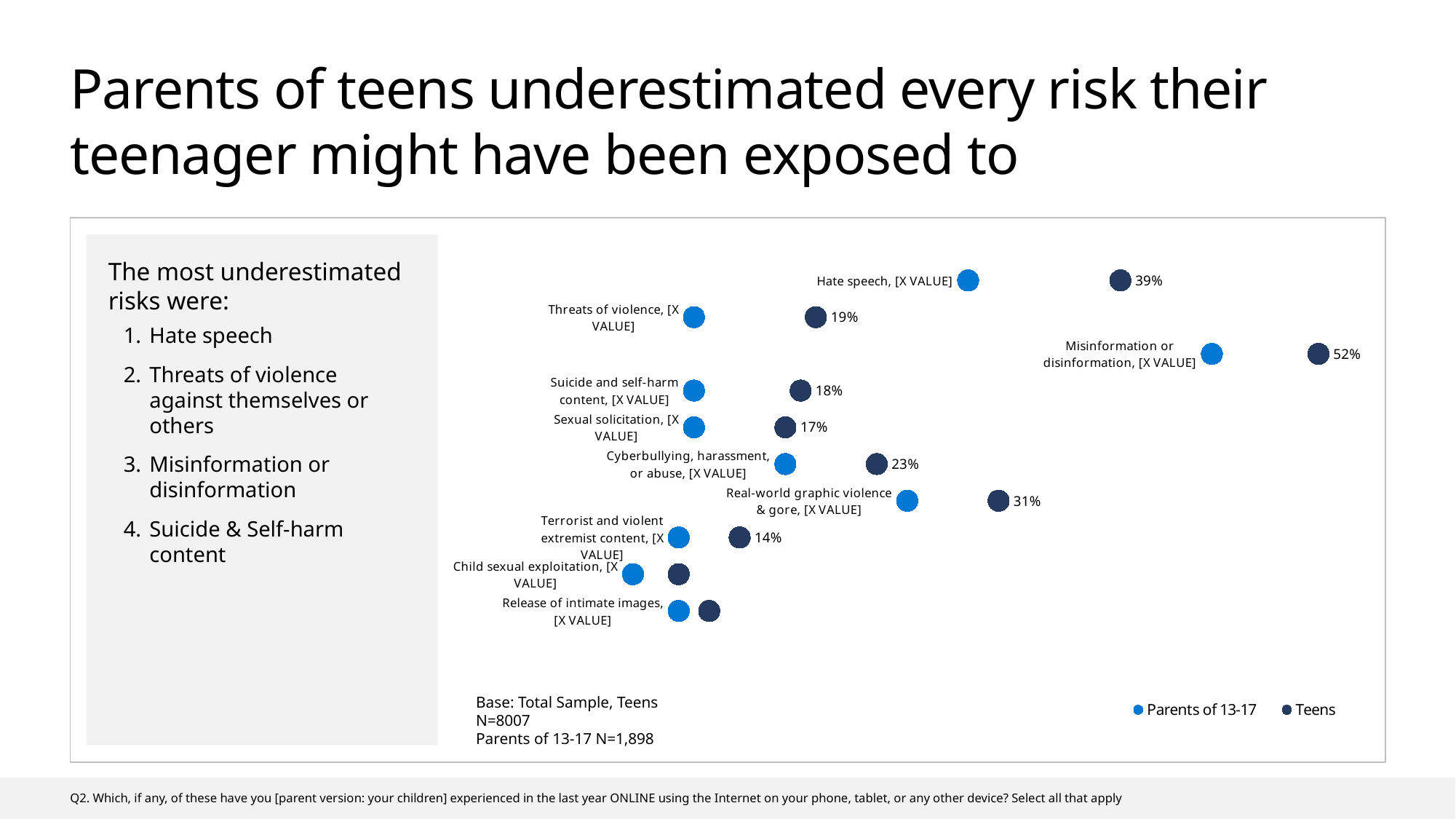
For every risk, which series shows the higher value: Parents of 13-17 or Teens? Teens What percentage of teens reported exposure to misinformation or disinformation? 52% How many series does the legend list? 2 What kind of chart is shown on the slide? Dot plot (scatter chart) How many risk categories are plotted in the chart? 10 Which has a higher Teens value: cyberbullying, harassment, or abuse, or real-world graphic violence & gore? Real-world graphic violence & gore What is the Teens value for hate speech? 39% Which risk has the highest Teens value? Misinformation or disinformation What is the Teens value for cyberbullying, harassment, or abuse? 23% What is the Teens value for terrorist and violent extremist content? 14% What percentage of teens reported exposure to real-world graphic violence & gore? 31% What is the difference between the Teens values for misinformation or disinformation and hate speech? 13 percentage points